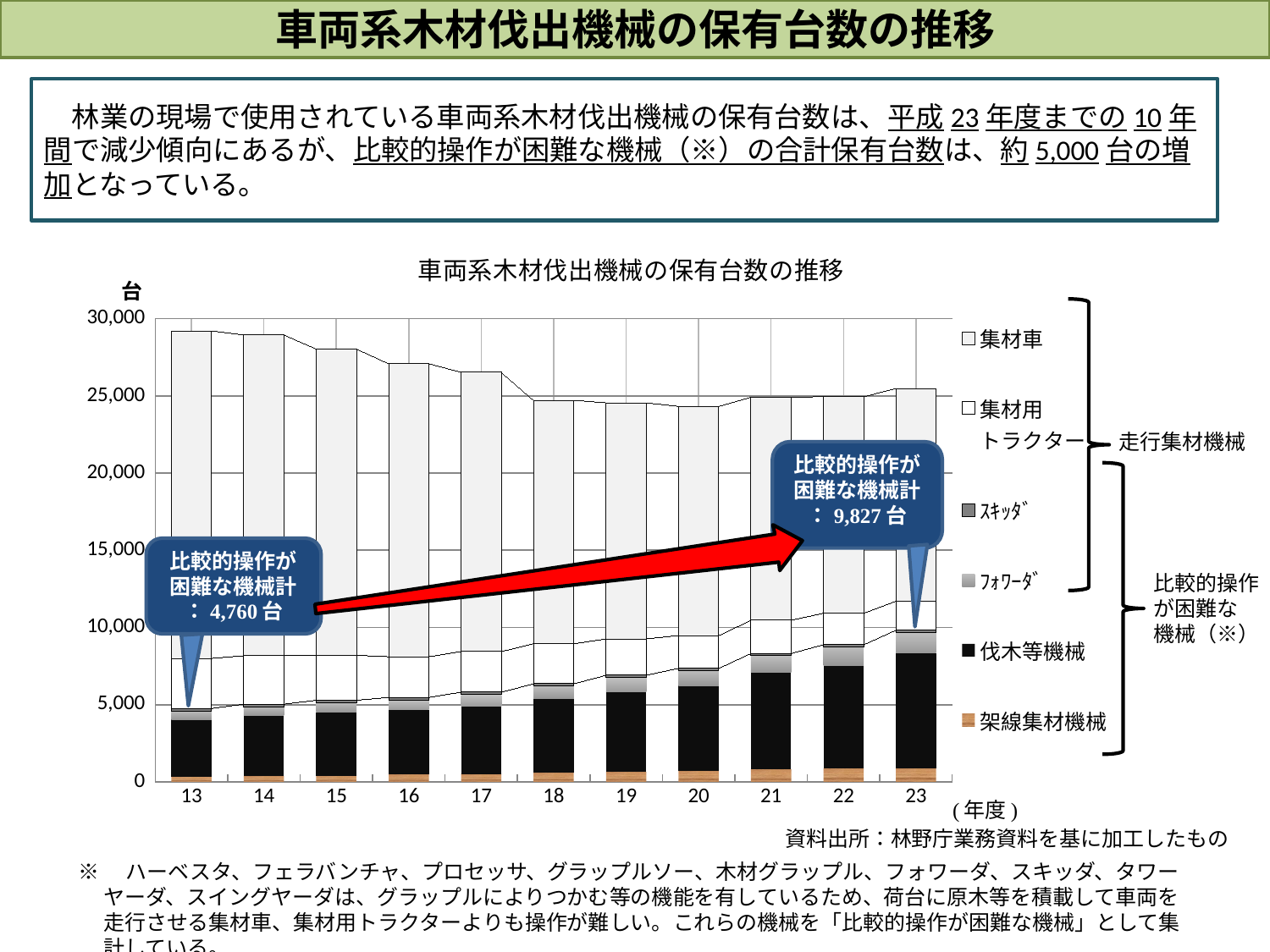
According to the callout, what is the total number of 比較的操作が困難な機械 in fiscal year 13? 4,760台 What type of chart is shown on the slide? Stacked bar chart How many fiscal years (categories) are plotted on the x axis? 11 According to the callout, what is the total number of 比較的操作が困難な機械 in fiscal year 23? 9,827台 By how much did the total of 比較的操作が困難な機械 increase from fiscal year 13 to fiscal year 23, based on the callout values? 5,067台 How many series does the legend list? 6 Which fiscal year has the highest total stacked bar? 13 Which is larger: the 伐木等機械 segment in fiscal year 23 or in fiscal year 13? Fiscal year 23 Is the total stacked bar for fiscal year 20 greater or less than 25,000? less Does the total number of machines generally rise or fall from fiscal year 13 to fiscal year 23? fall What is the title of the chart? 車両系木材伐出機械の保有台数の推移 Is the total stacked bar for fiscal year 13 greater or less than 25,000? greater